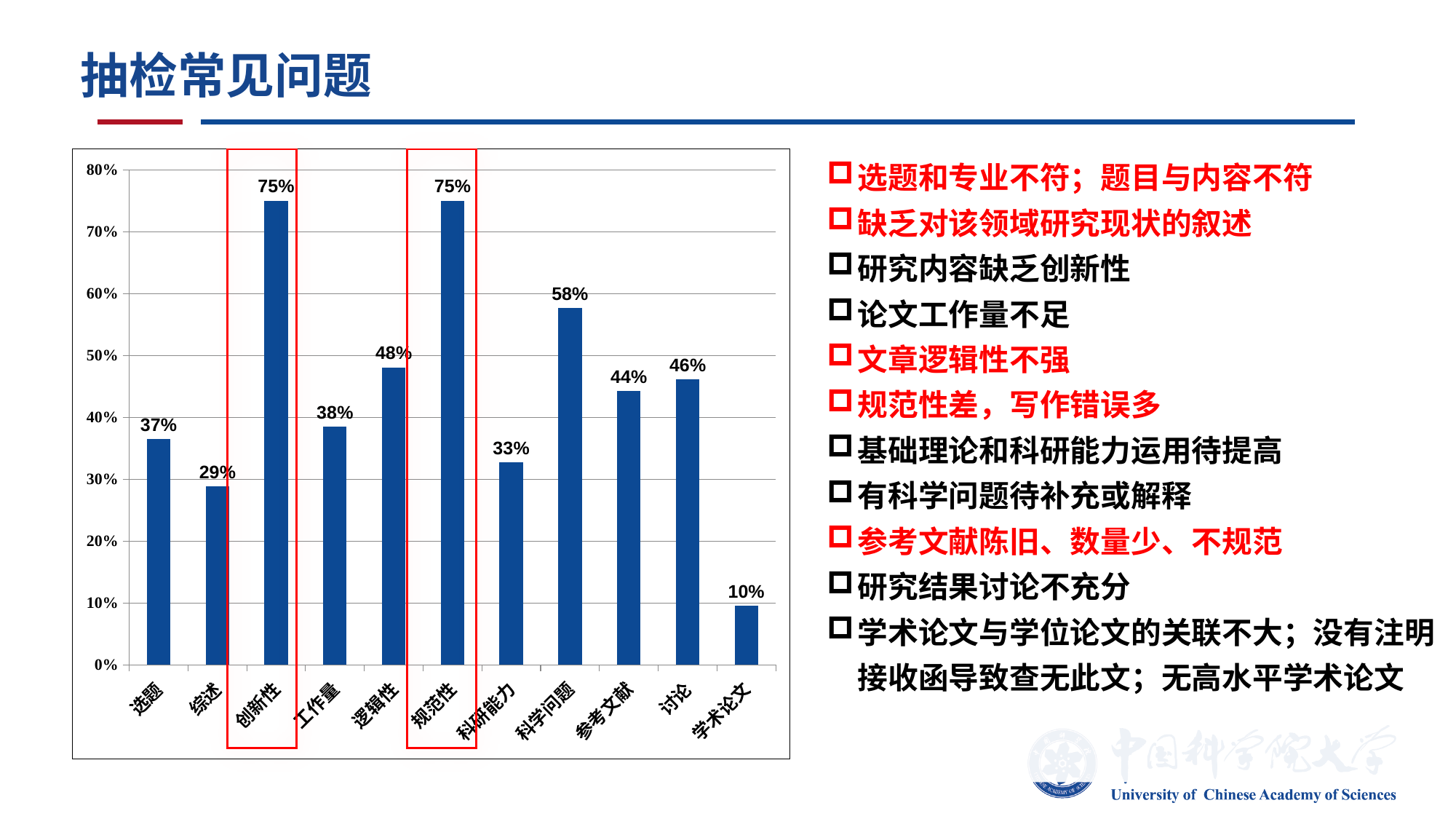
Which two categories are outlined with red boxes in the chart? 创新性 and 规范性 Is the value for 综述 greater or less than 30%? less Which category has the lowest value? 学术论文 What is the value for 科学问题? 58% What is the difference between the values for 科学问题 and 学术论文? 48% What is the difference between the values for 逻辑性 and 工作量? 10% What is the value for 参考文献? 44% Which is larger, the value for 讨论 or the value for 参考文献? 讨论 How many categories are plotted in the bar chart? 11 What kind of chart is shown on the slide? bar chart Which two categories share the highest value of 75%? 创新性 and 规范性 What is the value for 选题? 37%